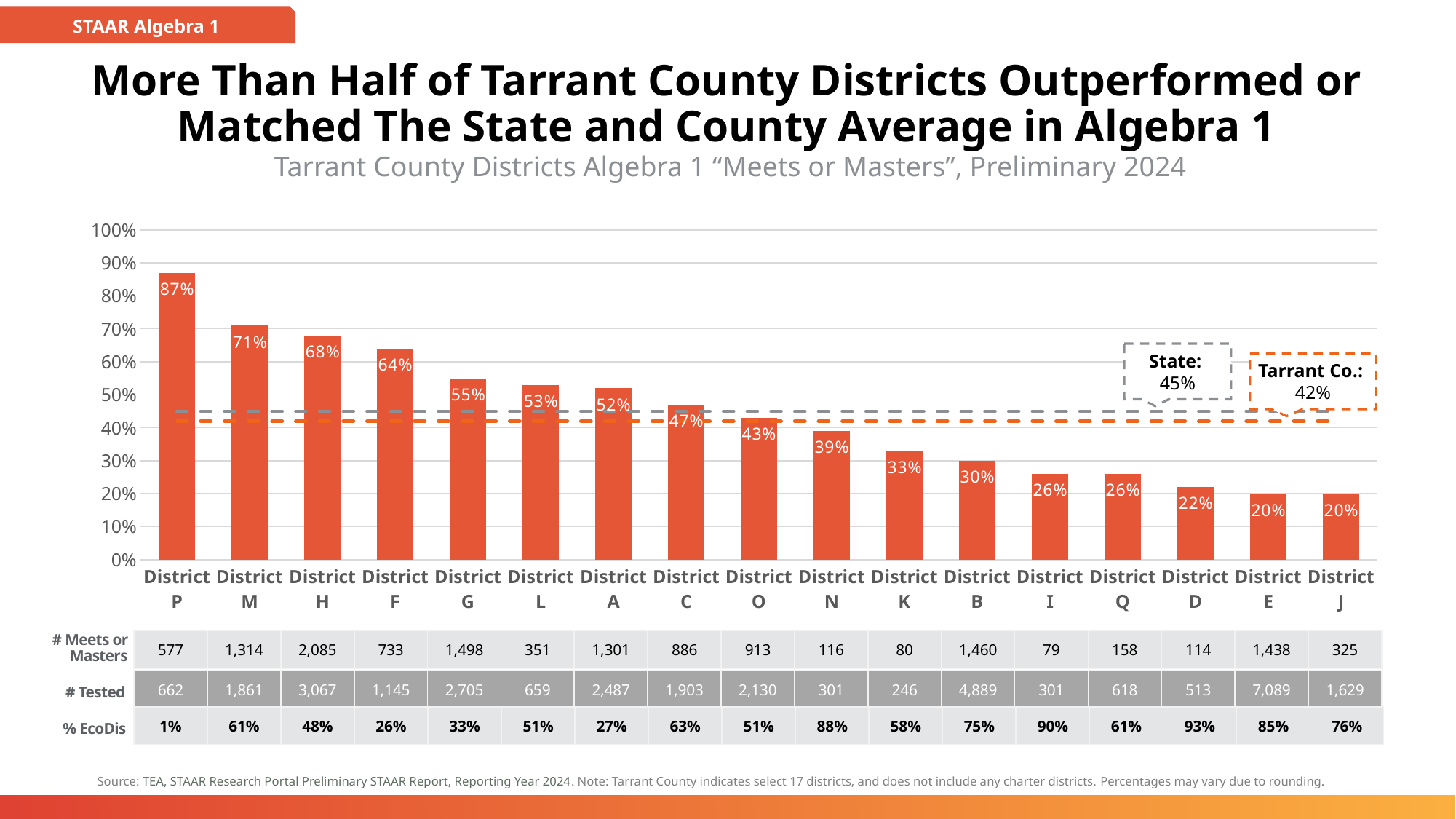
What kind of chart is shown on the slide? bar chart What is the "Meets or Masters" percentage for District C? 47% Which has a higher "Meets or Masters" percentage, District G or District N? District G What is the "Meets or Masters" percentage for District P? 87% Do the bar values rise or fall from left to right along the x axis? fall What is the difference in "Meets or Masters" percentage between District P and District J? 67% What is the State average shown by the dashed line? 45% Is the value for District O greater or less than 50%? less What is the Tarrant County average shown by the dashed line? 42% Which district has the highest "Meets or Masters" percentage? District P How many districts are shown on the chart? 17 What is the difference in "Meets or Masters" percentage between District M and District H? 3%